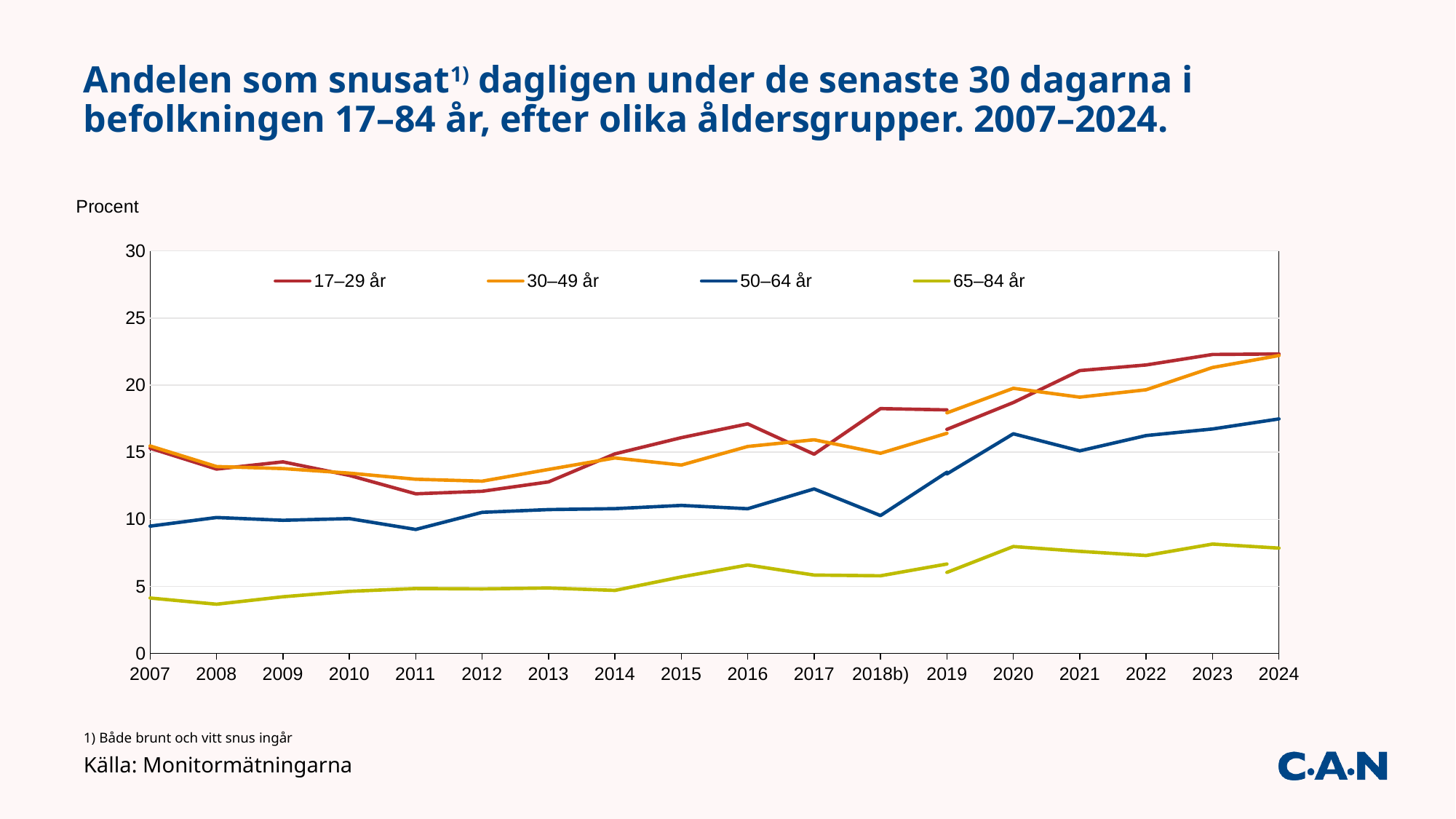
What is the label on the y axis of the chart? Procent Which age group has the lowest values across the whole period? 65–84 år Is the value for 17–29 år in 2024 greater or less than 20? greater How many years are shown along the x axis? 18 Does the value for 50–64 år rise or fall overall from 2007 to 2024? Rise What kind of chart is shown on the slide? Line chart How many series does the legend list? 4 Is the value for 65–84 år in 2024 greater or less than 10? less Is the value for 50–64 år in 2020 greater or less than 15? greater Which age group has the highest value in 2021? 17–29 år In 2018b), which is larger: the value for 17–29 år or for 30–49 år? 17–29 år